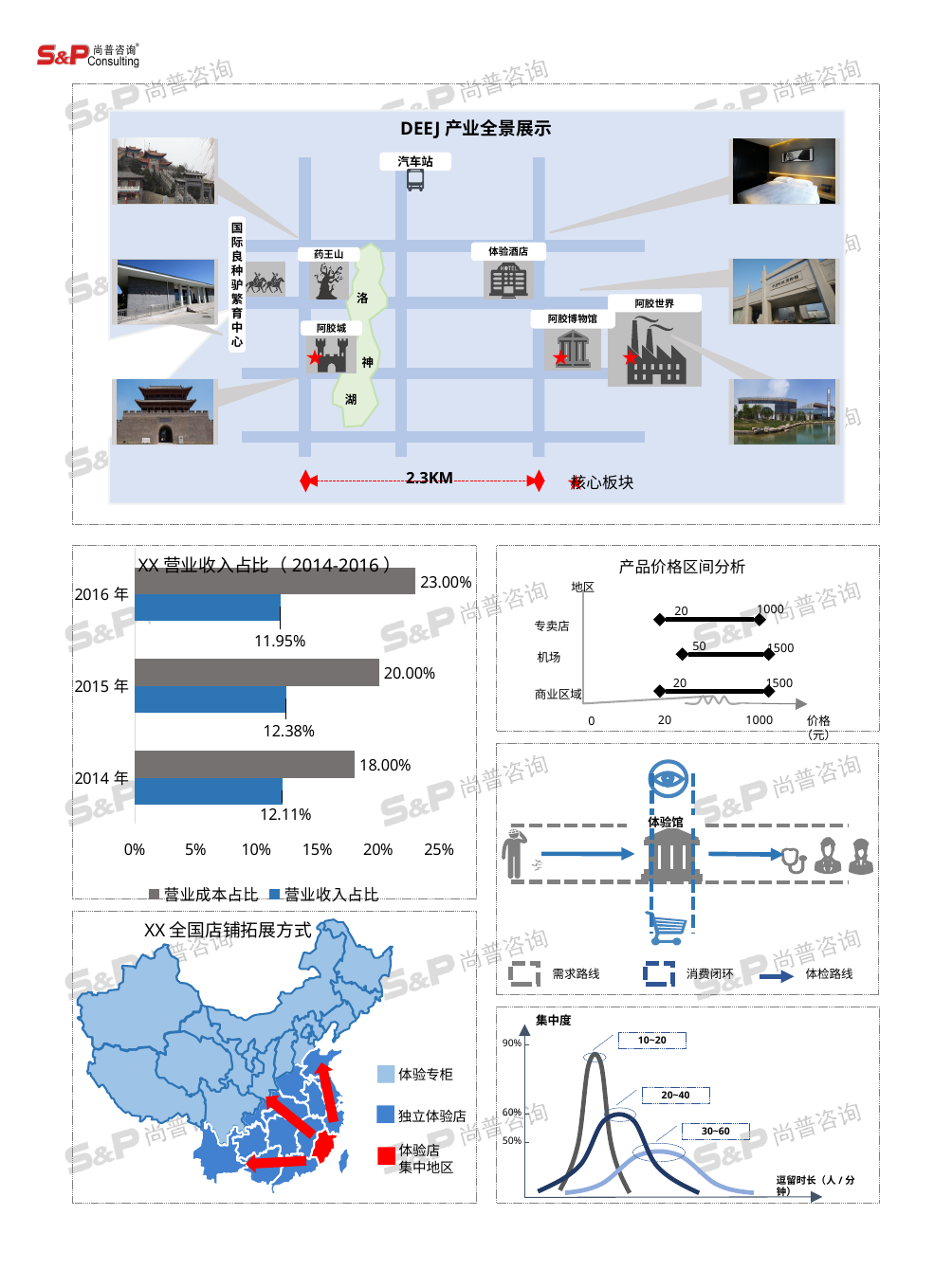
In the chart titled "XX 营业收入占比（2014-2016）", is the 营业成本占比 for 2015 年 larger or smaller than the 营业成本占比 for 2014 年? larger In the chart titled "XX 营业收入占比（2014-2016）", what is the 营业收入占比 value for 2014 年? 12.11% In the chart titled "XX 营业收入占比（2014-2016）", does the 营业成本占比 rise or fall from 2014 年 to 2016 年? rise In the chart titled "XX 营业收入占比（2014-2016）", what is the 营业成本占比 value for 2016 年? 23.00% In the chart titled "产品价格区间分析", what is the upper price value shown for 机场? 1500 In the chart titled "XX 营业收入占比（2014-2016）", which year has the lowest 营业收入占比? 2016 年 In the chart titled "XX 营业收入占比（2014-2016）", what is the difference between 营业成本占比 and 营业收入占比 for 2014 年? 5.89% In the chart titled "XX 营业收入占比（2014-2016）", which year has the highest 营业成本占比? 2016 年 In the chart titled "XX 营业收入占比（2014-2016）", how many series does the legend list? 2 What kind of chart is "XX 营业收入占比（2014-2016）"? bar chart In the chart titled "XX 营业收入占比（2014-2016）", how many years are shown on the axis? 3 In the chart titled "XX 营业收入占比（2014-2016）", what is the 营业收入占比 value for 2015 年? 12.38%